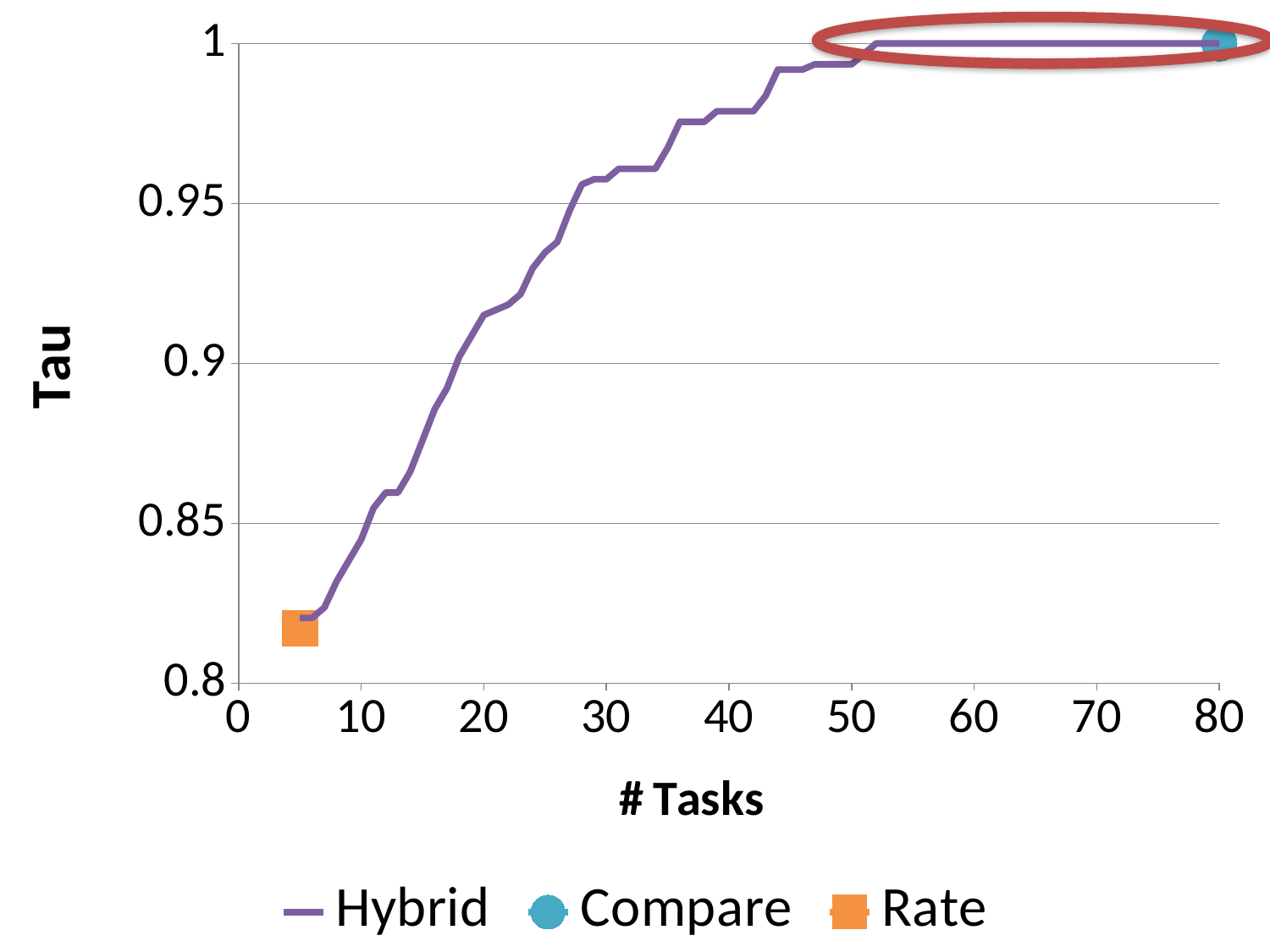
Is the Tau value for Hybrid at 20 tasks greater or less than 0.9? greater Is the Tau value for the Rate point greater or less than 0.85? less How many series does the legend list? 3 Which has the higher Tau value, the Compare point or the Rate point? Compare Is the Tau value for Hybrid at 10 tasks greater or less than 0.85? less Does the Hybrid line rise or fall as the number of tasks increases? rises What Tau value does the Compare point reach? 1 What is the label of the horizontal axis? # Tasks What Tau value does the Hybrid line reach at 60 tasks? 1 What is the label of the vertical axis? Tau What kind of chart is this? line chart